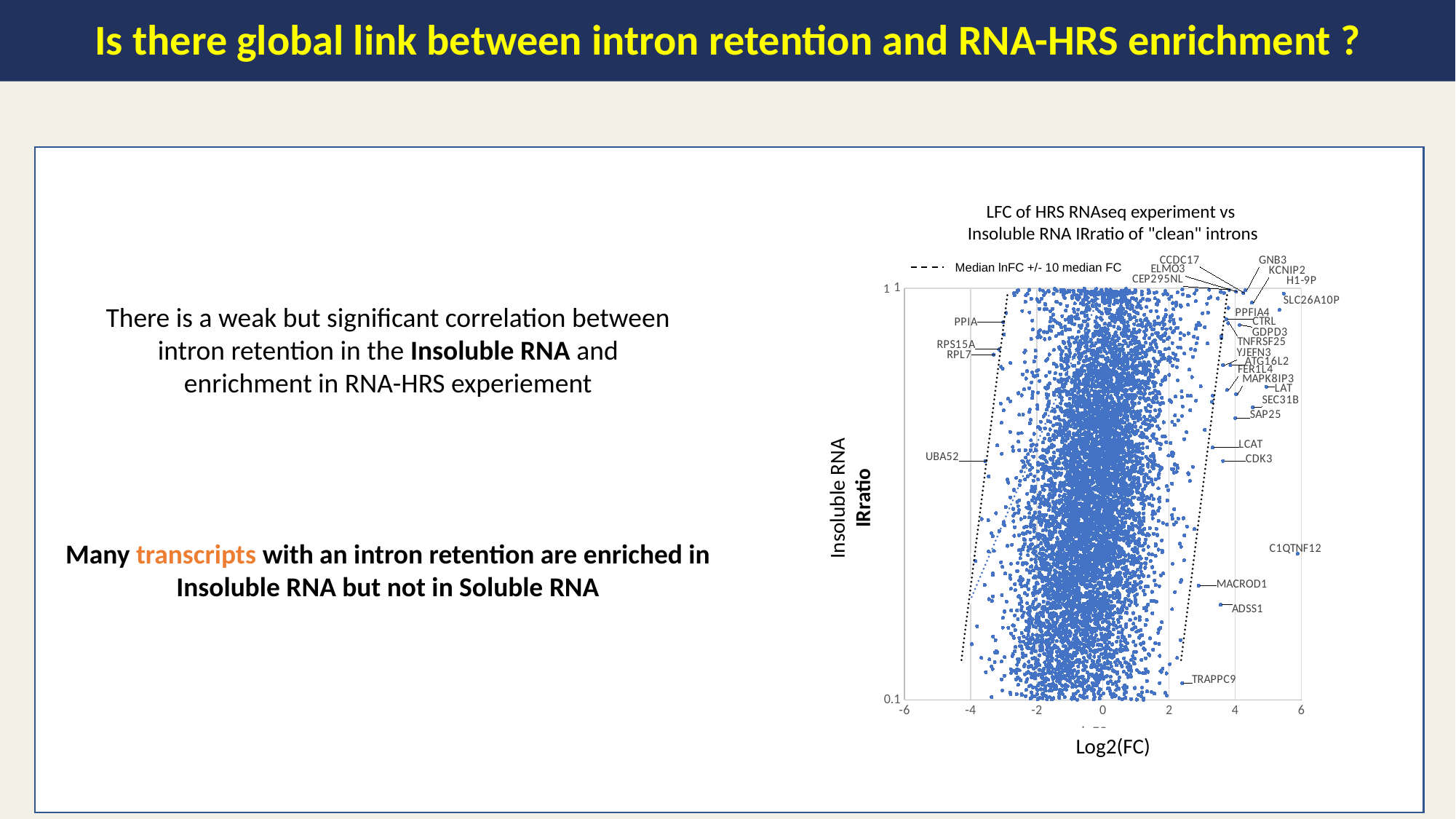
Which labeled point has the lower Insoluble RNA IRratio, TRAPPC9 or GNB3? TRAPPC9 Which labeled point has the larger Log2(FC) value, C1QTNF12 or UBA52? C1QTNF12 What kind of chart is shown on the slide? scatter plot Is the Log2(FC) value for MACROD1 greater or less than 0? greater Which labeled point has the larger Log2(FC) value, RPL7 or CDK3? CDK3 Is the Log2(FC) value for UBA52 greater or less than -2? less Is the Log2(FC) value for PPIA greater or less than 0? less What is the title of the chart? LFC of HRS RNAseq experiment vs Insoluble RNA IRratio of "clean" introns What is the label of the x axis of the chart? Log2(FC)